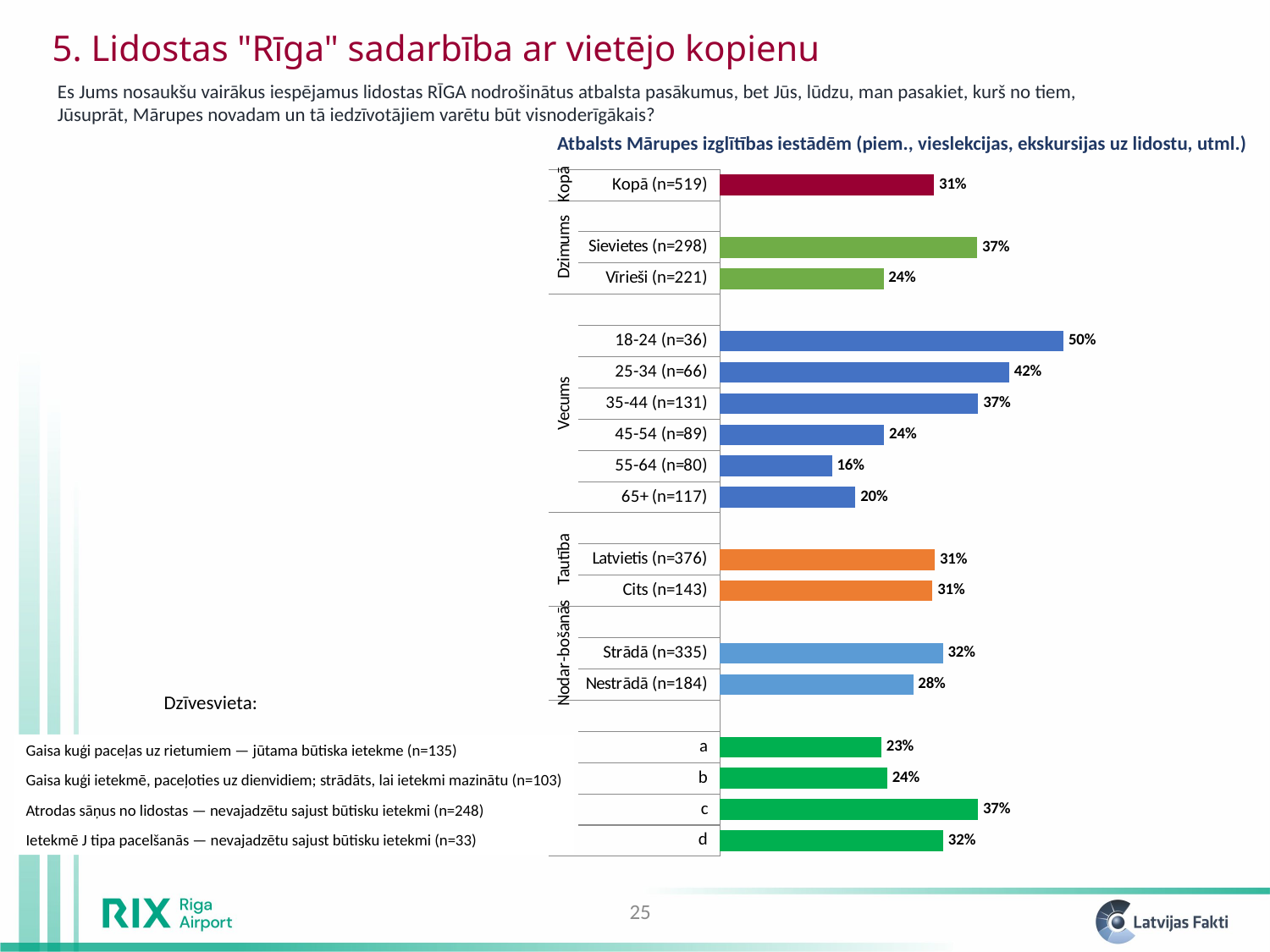
What is the value for Kopā (n=519)? 31% What is the value for Nestrādā (n=184)? 28% What is the difference between the values for 18-24 (n=36) and 65+ (n=117)? 30% What is the value for 55-64 (n=80)? 16% What is the difference between the values for Sievietes (n=298) and Vīrieši (n=221)? 13% What kind of chart is shown on the slide? bar chart What is the value for Sievietes (n=298)? 37% Which category has the lowest value in the chart? 55-64 (n=80) Which category has the highest value in the chart? 18-24 (n=36) What is the title of the chart? Atbalsts Mārupes izglītības iestādēm (piem., vieslekcijas, ekskursijas uz lidostu, utml.) How many bars are plotted in the chart? 17 Which is larger, the value for 25-34 (n=66) or the value for 35-44 (n=131)? 25-34 (n=66)